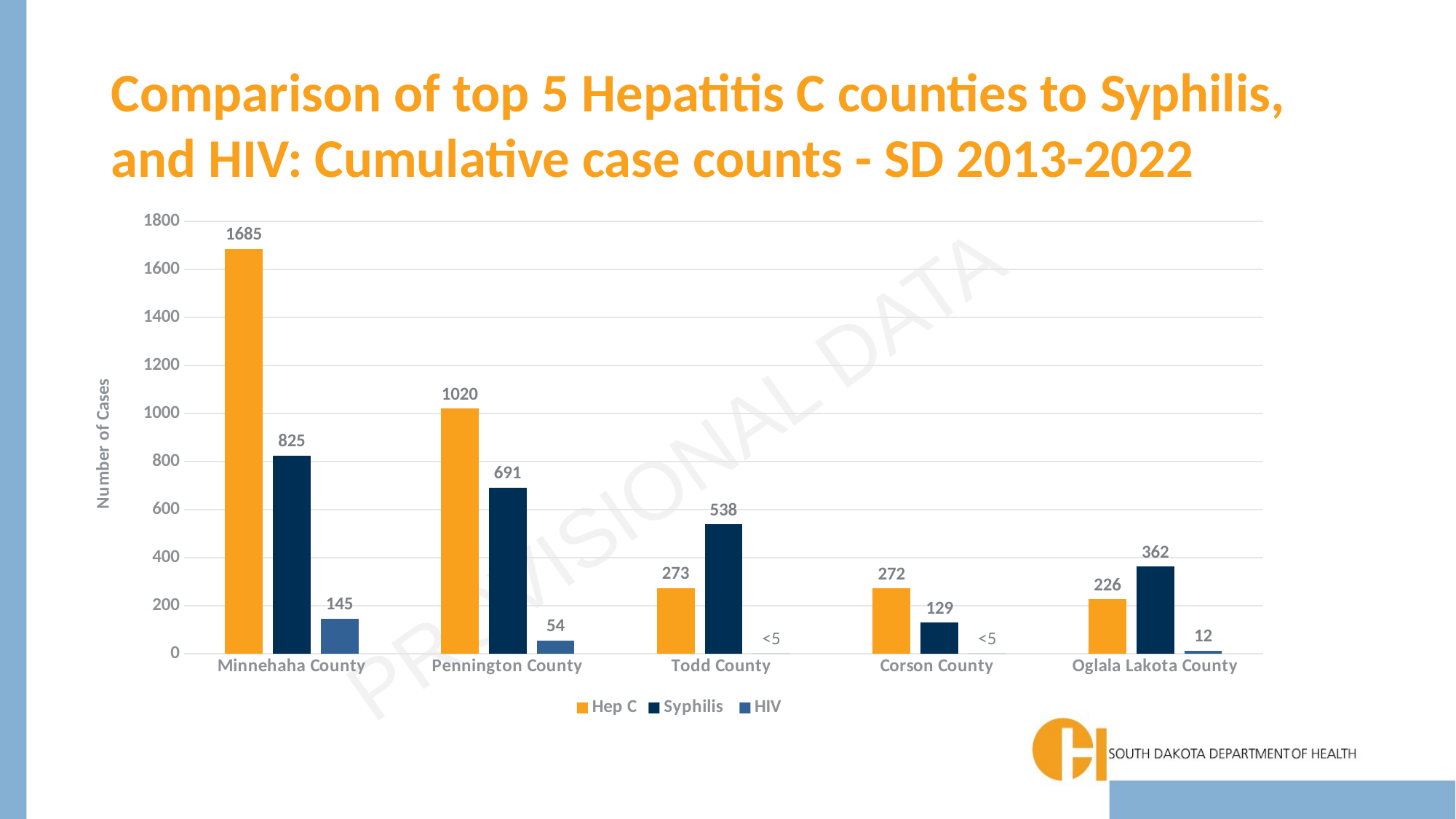
What is the difference between the Hep C and Syphilis values for Minnehaha County? 860 What kind of chart is shown on the slide? Bar chart Which is larger for Todd County, the Hep C value or the Syphilis value? Syphilis What is the Hep C value for Minnehaha County? 1685 What is the HIV value for Oglala Lakota County? 12 How many counties are shown on the x axis? 5 Which county has the highest Hep C value? Minnehaha County What is the Syphilis value for Pennington County? 691 What is the Syphilis value for Todd County? 538 How many series does the legend list? 3 What is the label on the vertical axis? Number of Cases Which county has the lowest Syphilis value? Corson County